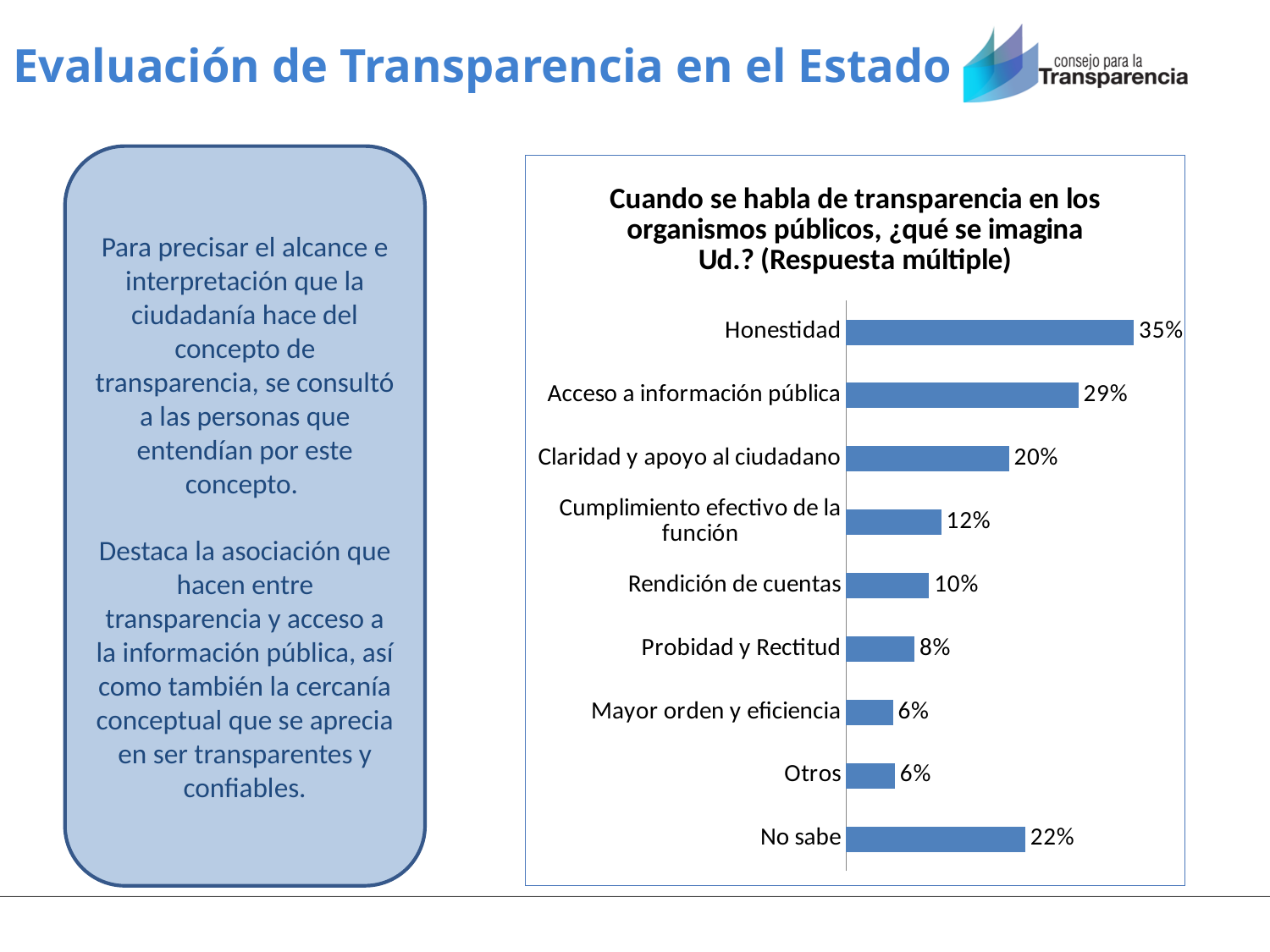
What is the difference between Honestidad and Acceso a información pública? 6% What is the value for Honestidad? 35% What kind of chart is shown on the slide? Bar chart What is the value for No sabe? 22% How many categories are shown in the chart? 9 What is the title of the chart? Cuando se habla de transparencia en los organismos públicos, ¿qué se imagina Ud.? (Respuesta múltiple) Which category has the highest value? Honestidad What is the value for Acceso a información pública? 29% Which is larger, No sabe or Claridad y apoyo al ciudadano? No sabe What is the difference between Claridad y apoyo al ciudadano and Rendición de cuentas? 10% What is the value for Cumplimiento efectivo de la función? 12% Which is larger, Probidad y Rectitud or Rendición de cuentas? Rendición de cuentas